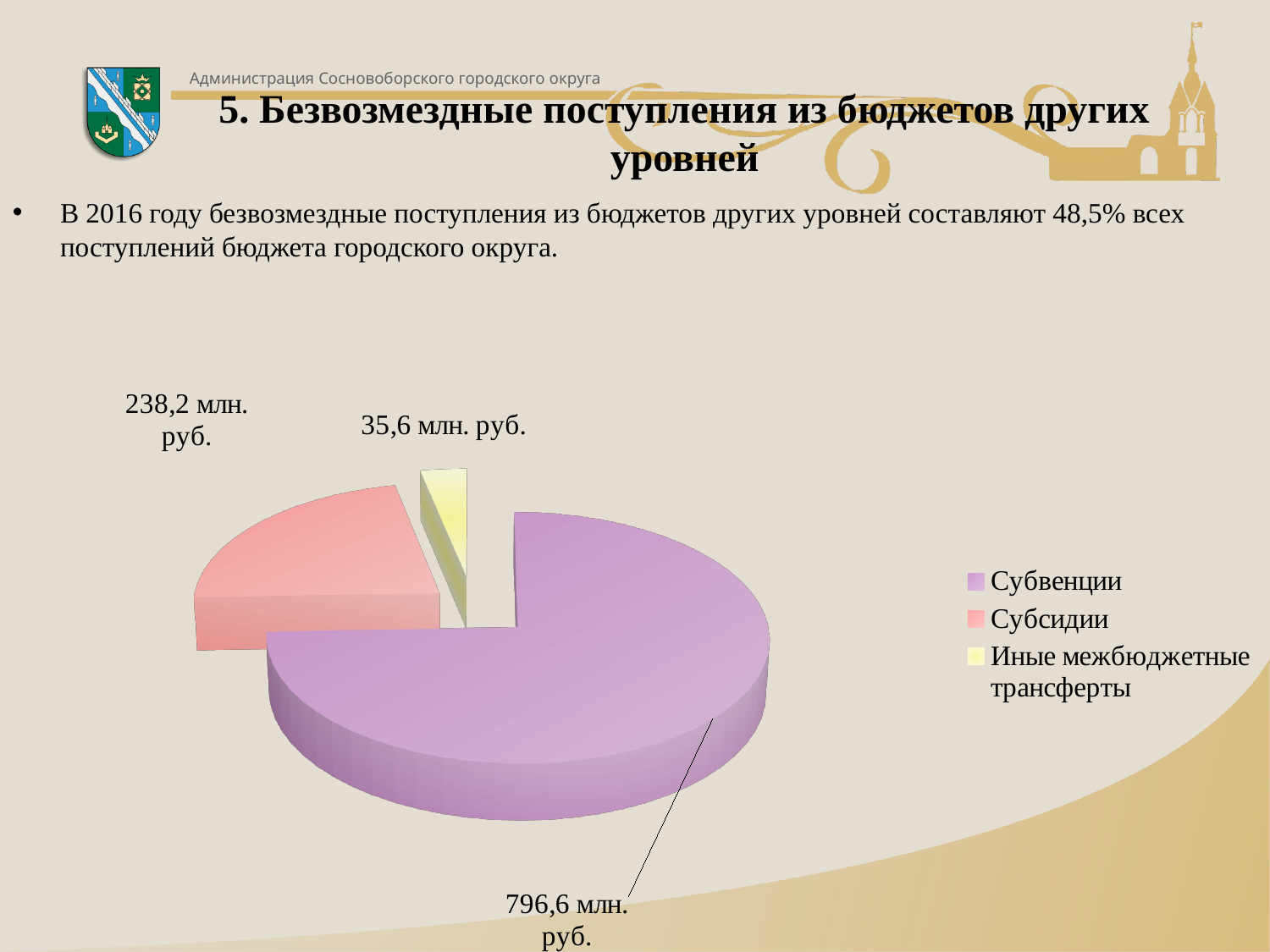
What kind of chart is shown on the slide? Pie chart What colour is the Субвенции slice in the pie chart? Purple What is the difference between the Субвенции and Субсидии values? 558,4 млн. руб. Which category has the smallest slice in the pie chart? Иные межбюджетные трансферты How many slices does the pie chart have? 3 Which category has the largest slice in the pie chart? Субвенции What is the value of the Иные межбюджетные трансферты slice? 35,6 млн. руб. What is the value of the Субсидии slice? 238,2 млн. руб. What is the total of all three slices in the pie chart? 1070,4 млн. руб. How many entries does the legend of the pie chart list? 3 Which is larger, Субсидии or Иные межбюджетные трансферты? Субсидии What is the value of the Субвенции slice? 796,6 млн. руб.